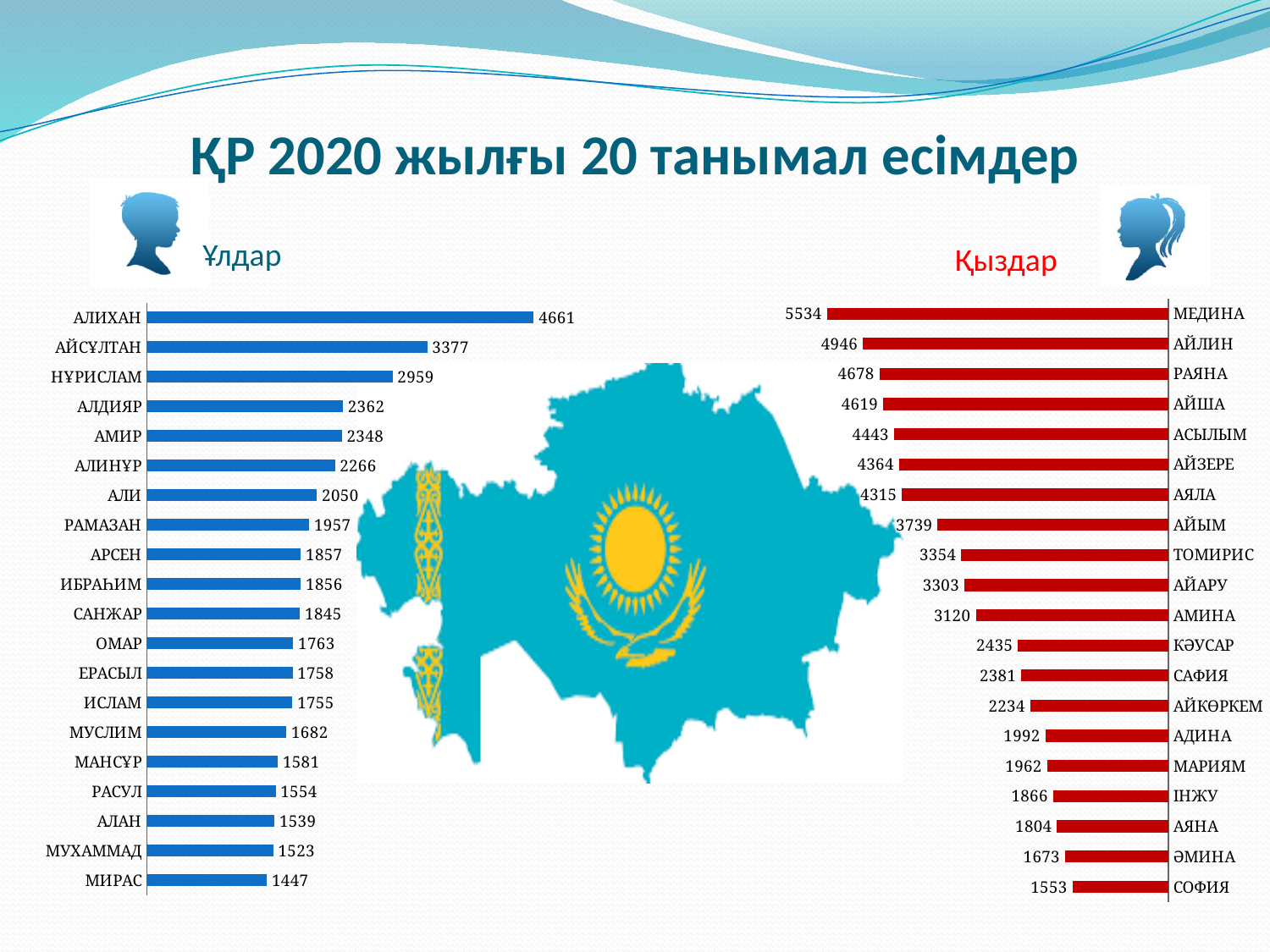
How many names are shown in the Қыздар (girls) chart on the right? 20 In the Ұлдар (boys) chart on the left, which is larger: the value for АЛДИЯР or the value for АЛИ? АЛДИЯР How many names are shown in the Ұлдар (boys) chart on the left? 20 In the Қыздар (girls) chart on the right, what is the difference between МЕДИНА and АЙЛИН? 588 In the Қыздар (girls) chart on the right, which name has the highest value? МЕДИНА In the Ұлдар (boys) chart on the left, what is the difference between АЛИХАН and АЙСҰЛТАН? 1284 What colour are the bars in the Ұлдар (boys) chart on the left? Blue In the Ұлдар (boys) chart on the left, what is the value for АЛИХАН? 4661 In the Қыздар (girls) chart on the right, which is larger: the value for ТОМИРИС or the value for КӘУСАР? ТОМИРИС What type of chart is the Қыздар (girls) chart on the right? Bar chart In the Ұлдар (boys) chart on the left, which name has the lowest value? МИРАС In the Қыздар (girls) chart on the right, what is the value for МЕДИНА? 5534